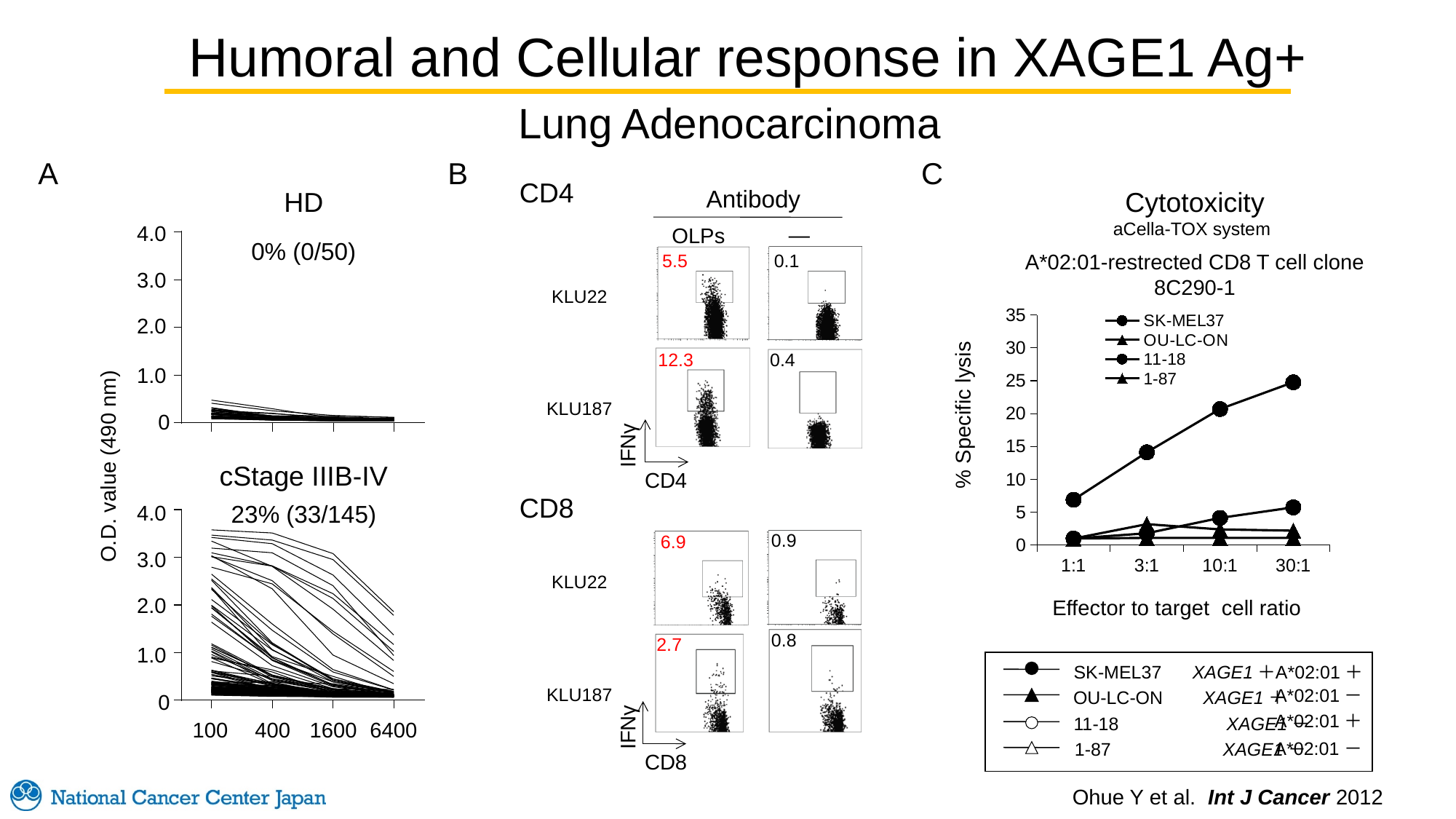
What kind of chart is the Cytotoxicity chart in panel C? line chart In the Cytotoxicity chart (panel C), which series has the highest % specific lysis at the 30:1 ratio? SK-MEL37 In the Cytotoxicity chart (panel C), is the % specific lysis for SK-MEL37 at 1:1 greater or less than 10? less In the Cytotoxicity chart (panel C), does the % specific lysis for SK-MEL37 rise or fall as the effector to target cell ratio increases? rise In panel B, what is the difference between the OLPs and the no-antibody values for KLU187 CD4 cells (12.3 vs 0.4)? 11.9 In panel A, what percentage is shown for the HD chart? 0% (0/50) In panel B, what value is printed for KLU187 CD4 cells stimulated with OLPs? 12.3 In panel A, what percentage of cStage IIIB-IV patients is shown as positive? 23% (33/145) In panel B, which is larger for KLU22 CD8 cells: the OLPs value or the no-antibody value? OLPs (6.9) In the Cytotoxicity chart (panel C), how many effector to target cell ratios are plotted on the x axis? 4 In the Cytotoxicity chart (panel C), how many series does the legend list? 4 In the Cytotoxicity chart (panel C), is the % specific lysis for SK-MEL37 at 30:1 greater or less than 20? greater